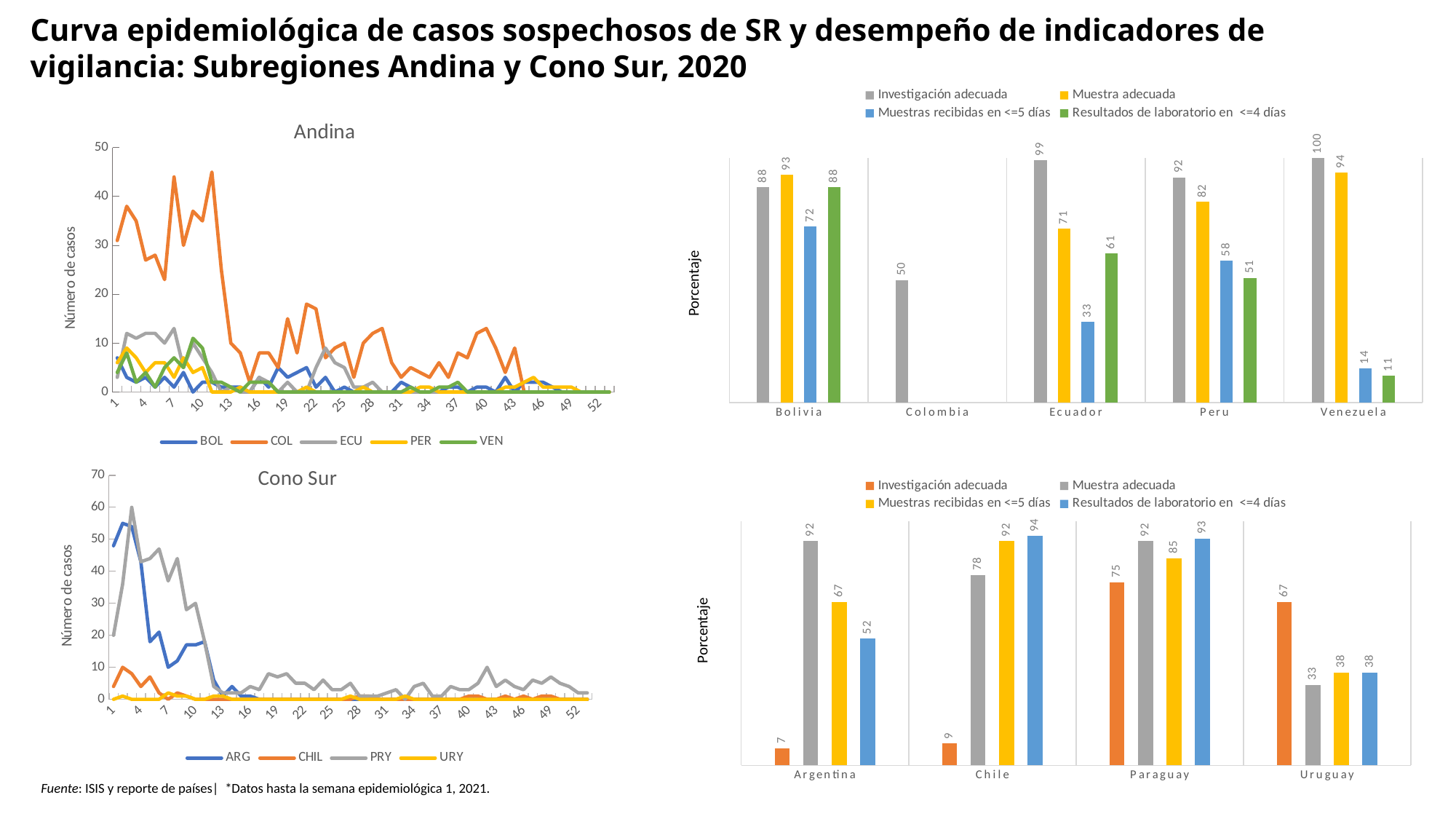
In the top-right bar chart, what is the value of Resultados de laboratorio en <=4 días for Venezuela? 11 In the Cono Sur chart, is the peak value of PRY greater or less than 50? greater In the top-right bar chart, which country has the highest value for Investigación adecuada? Venezuela How many series does the legend of the Andina line chart list? 5 In the top-right bar chart, what is the only value shown for Colombia? 50 What kind of chart is the Cono Sur chart? Line chart In the bottom-right bar chart, which is larger: Muestras recibidas en <=5 días for Chile or for Paraguay? Chile In the bottom-right bar chart, which country has the lowest value for Muestra adecuada? Uruguay In the top-right bar chart, what is the difference between Ecuador's Investigación adecuada and its Muestras recibidas en <=5 días? 66 How many countries are shown in the bottom-right bar chart? 4 In the top-right bar chart, what is the value of Muestra adecuada for Bolivia? 93 In the bottom-right bar chart, what is the value of Investigación adecuada for Argentina? 7